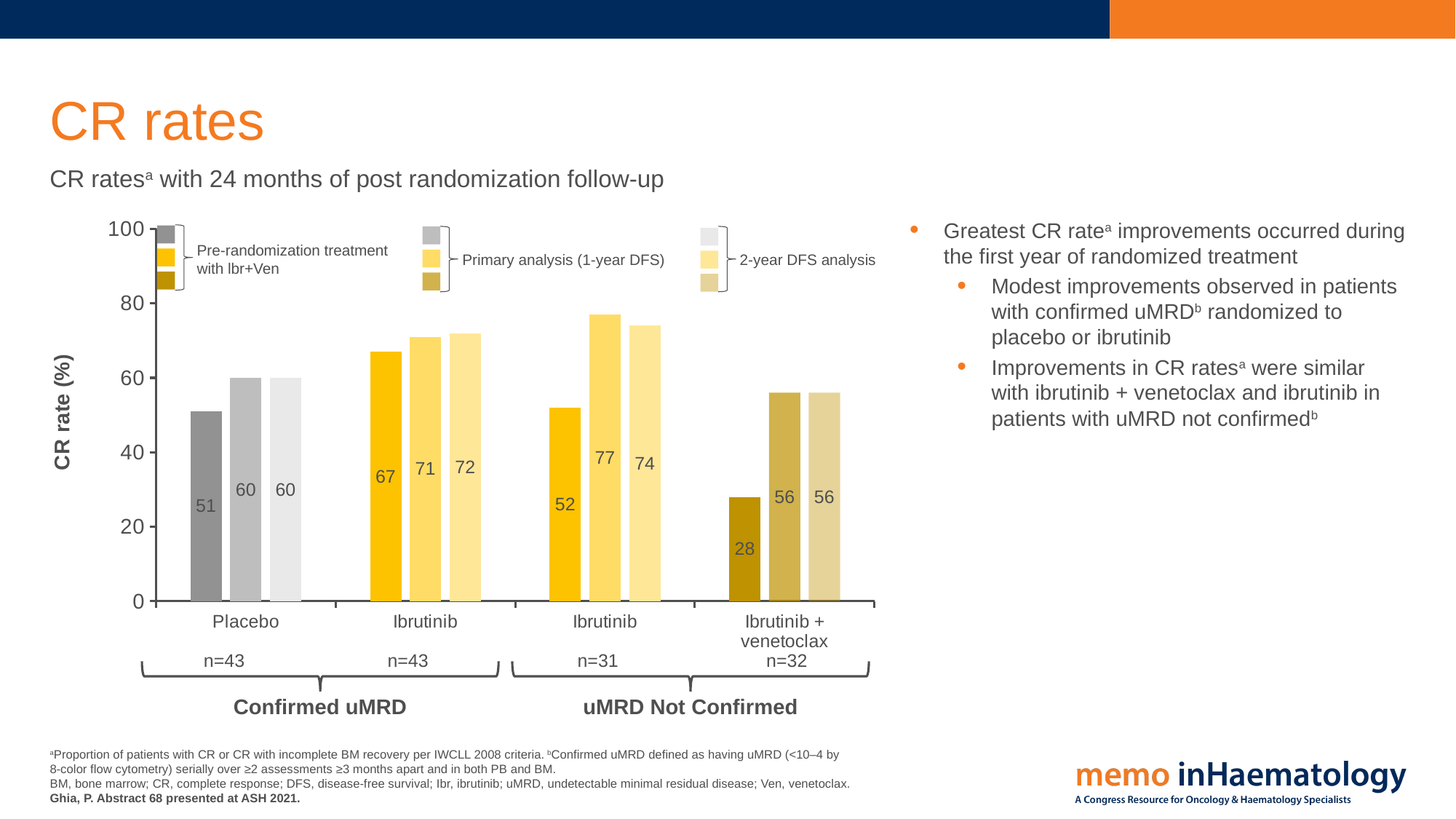
Which treatment group has the highest primary analysis (1-year DFS) CR rate? Ibrutinib (uMRD Not Confirmed) Is the 2-year DFS analysis CR rate higher for Ibrutinib in the Confirmed uMRD group or for Placebo? Ibrutinib (Confirmed uMRD) Which treatment group has the lowest pre-randomization CR rate? Ibrutinib + venetoclax What is the 2-year DFS analysis CR rate for Ibrutinib + venetoclax? 56 What is the pre-randomization CR rate for Ibrutinib + venetoclax? 28 How many treatment groups are shown on the x axis? 4 What kind of chart is shown on the slide? Bar chart What is the label of the y axis? CR rate (%) What is the primary analysis (1-year DFS) CR rate for Ibrutinib in the uMRD Not Confirmed group? 77 How many series does the legend list? 3 What is the pre-randomization CR rate for the Placebo group (Confirmed uMRD)? 51 What is the difference between the 2-year DFS analysis CR rate and the pre-randomization CR rate for Ibrutinib + venetoclax? 28